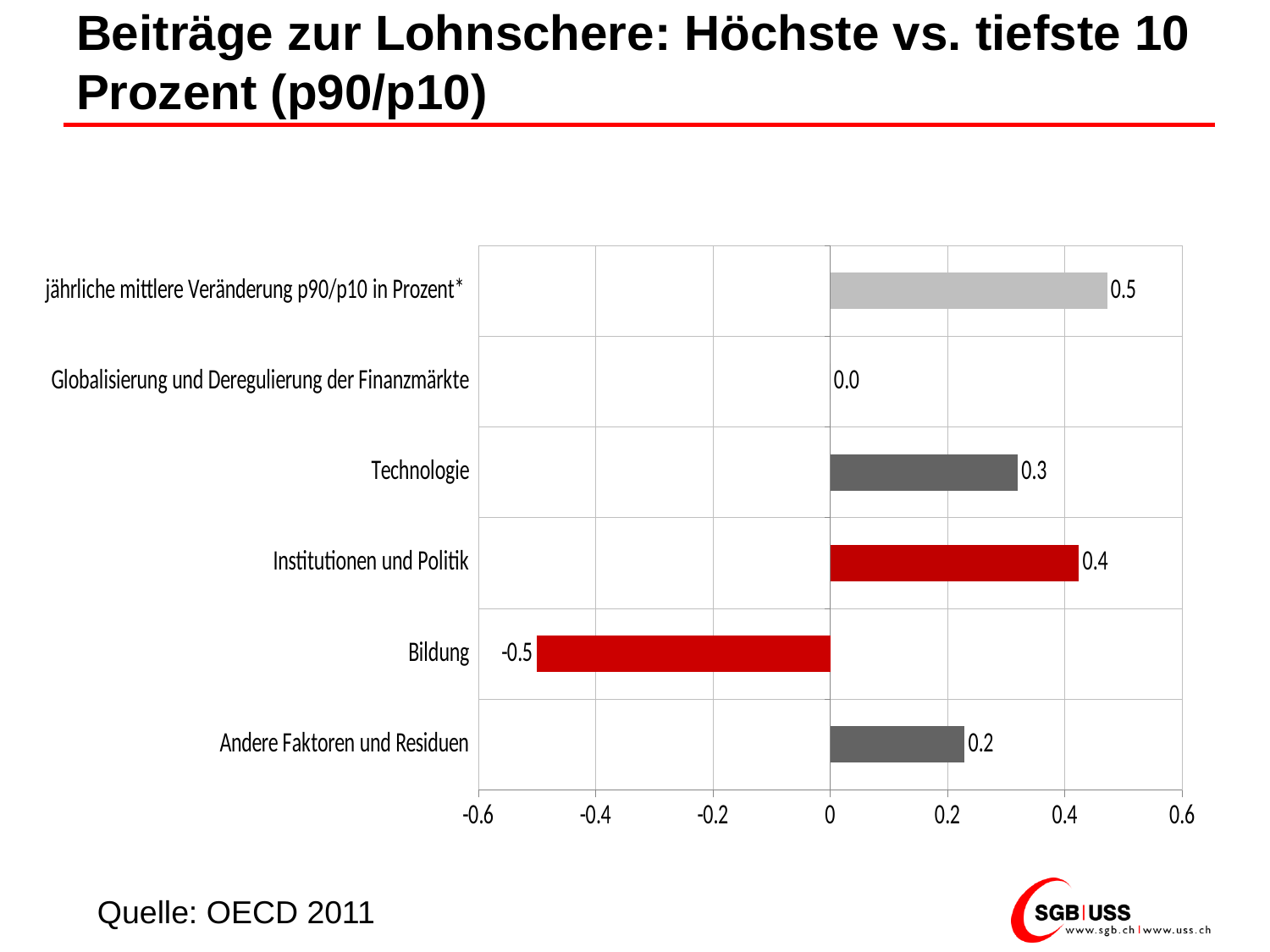
How many categories are shown in the chart? 6 What is the value for Bildung? -0.5 Which category has the highest value? jährliche mittlere Veränderung p90/p10 in Prozent* What is the difference between the values for Institutionen und Politik and Technologie? 0.1 What kind of chart is shown on the slide? bar chart What source is cited below the chart? OECD 2011 What is the value for Globalisierung und Deregulierung der Finanzmärkte? 0.0 What is the value for Technologie? 0.3 Which is larger, the value for Technologie or the value for Andere Faktoren und Residuen? Technologie Which category has the lowest value? Bildung What is the value for Andere Faktoren und Residuen? 0.2 What is the value for Institutionen und Politik? 0.4